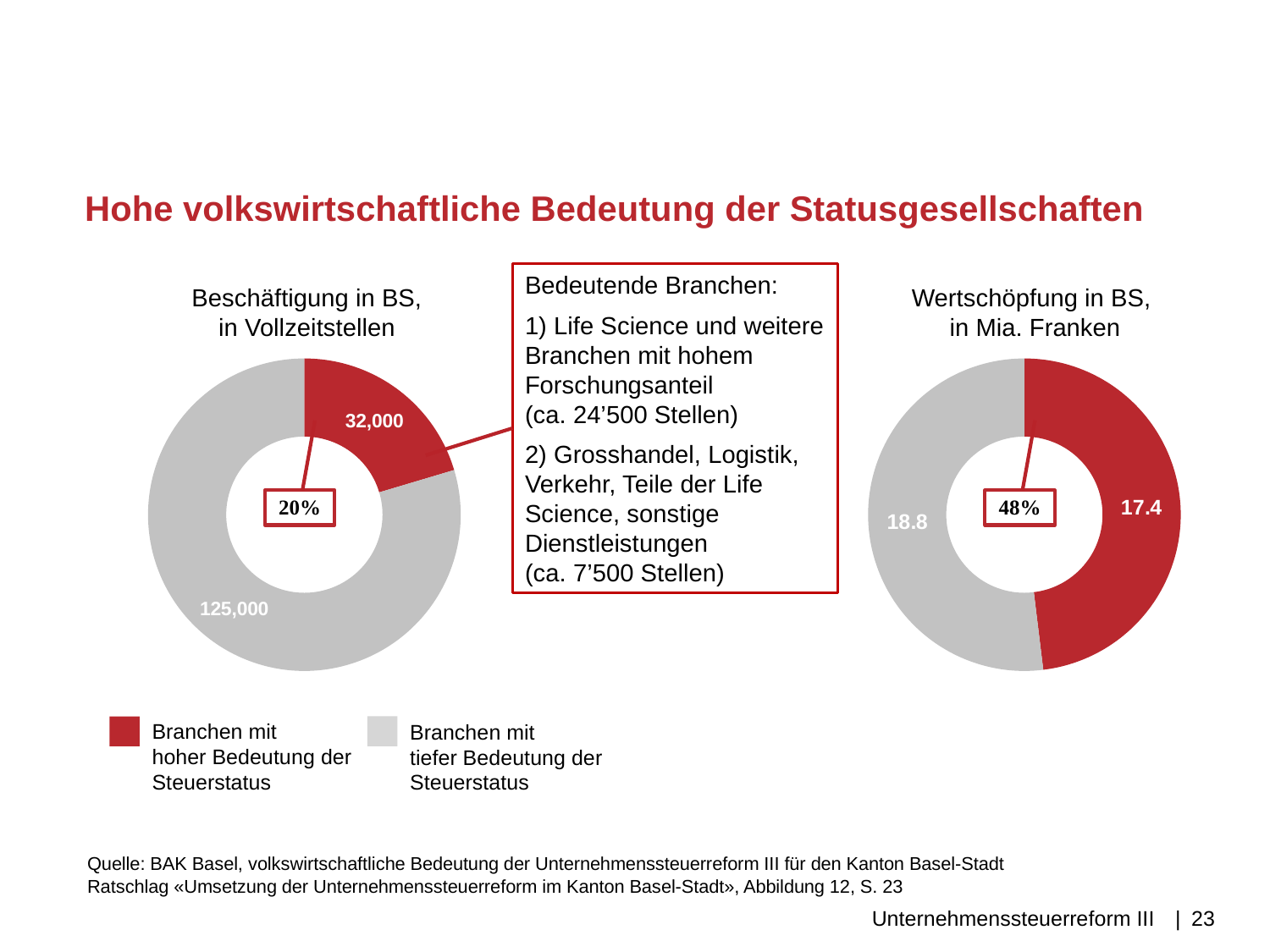
How many segments does the chart titled 'Beschäftigung in BS, in Vollzeitstellen' have? 2 In the chart titled 'Wertschöpfung in BS, in Mia. Franken', what is the difference between the grey segment (18.8) and the red segment (17.4)? 1.4 In the chart titled 'Beschäftigung in BS, in Vollzeitstellen', what is the value for 'Branchen mit tiefer Bedeutung der Steuerstatus'? 125,000 In the chart titled 'Beschäftigung in BS, in Vollzeitstellen', what share is shown in the centre label for the red segment? 20% In the chart titled 'Beschäftigung in BS, in Vollzeitstellen', which segment is larger? Branchen mit tiefer Bedeutung der Steuerstatus In the chart titled 'Wertschöpfung in BS, in Mia. Franken', what is the value for 'Branchen mit hoher Bedeutung der Steuerstatus'? 17.4 What kind of chart is used for 'Wertschöpfung in BS, in Mia. Franken'? Donut (pie) chart In the chart titled 'Beschäftigung in BS, in Vollzeitstellen', what is the value for 'Branchen mit hoher Bedeutung der Steuerstatus'? 32,000 In the chart titled 'Wertschöpfung in BS, in Mia. Franken', what is the value for 'Branchen mit tiefer Bedeutung der Steuerstatus'? 18.8 In the chart titled 'Beschäftigung in BS, in Vollzeitstellen', what is the difference between the 125,000 segment and the 32,000 segment? 93,000 In the chart titled 'Wertschöpfung in BS, in Mia. Franken', what share is shown in the centre label for the red segment? 48% Which colour represents 'Branchen mit hoher Bedeutung der Steuerstatus' in the legend? Red